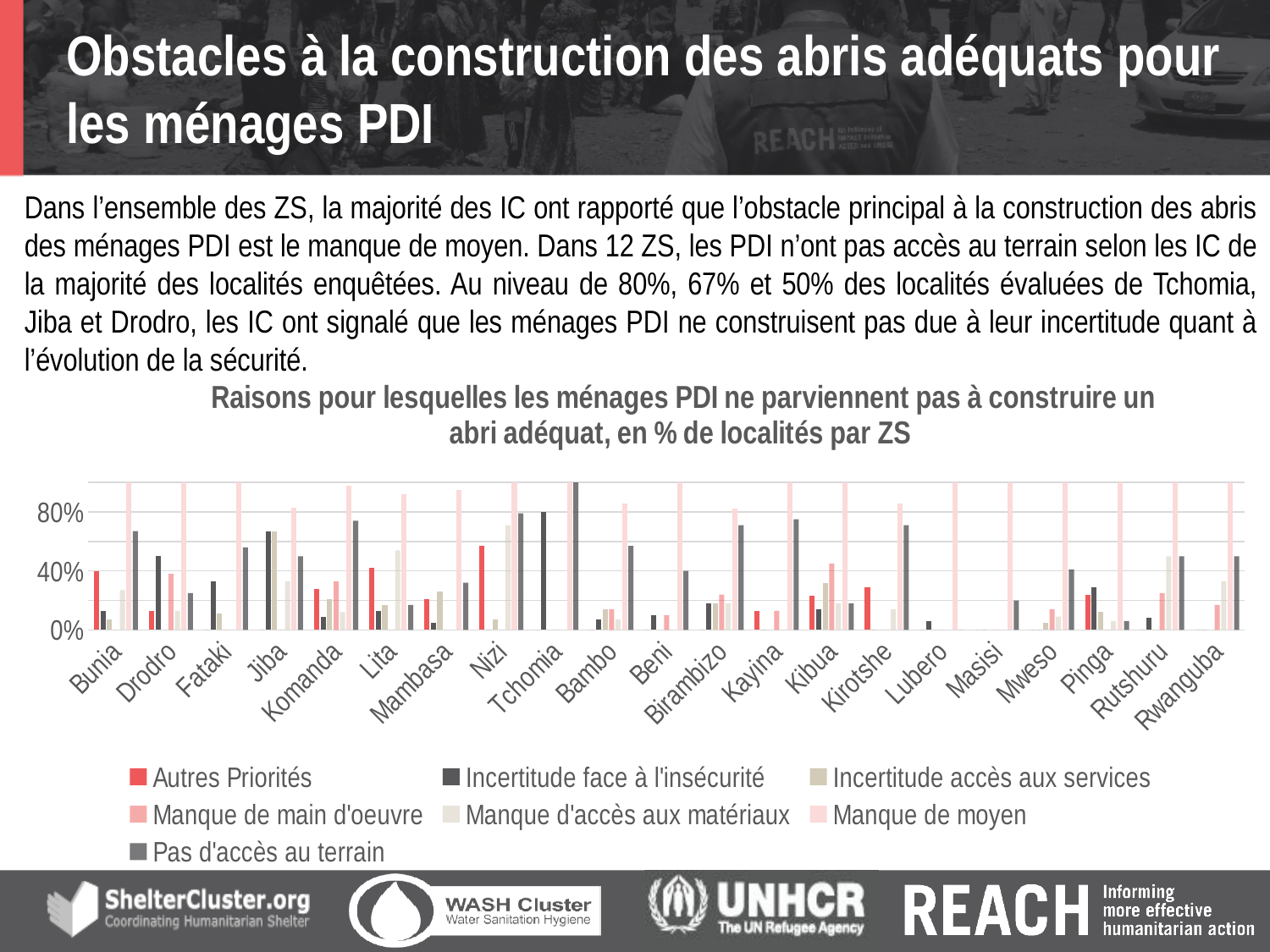
In Bunia, which is larger: the value for 'Manque de moyen' or the value for 'Autres Priorités'? Manque de moyen Is the value for 'Manque de moyen' in Bunia greater or less than 80%? greater Is the value for 'Pas d'accès au terrain' in Masisi greater or less than 40%? less In Kibua, which is larger: the value for 'Incertitude face à l'insécurité' or the value for 'Autres Priorités'? Autres Priorités Which colour represents the series 'Autres Priorités' in the chart legend? red Is the value for 'Pas d'accès au terrain' in Lubero greater or less than 40%? less What kind of chart is shown on the slide? bar chart How many series does the chart legend list? 7 How many zones de santé (categories) are shown along the x axis of the chart? 21 What is the title of the chart? Raisons pour lesquelles les ménages PDI ne parviennent pas à construire un abri adéquat, en % de localités par ZS